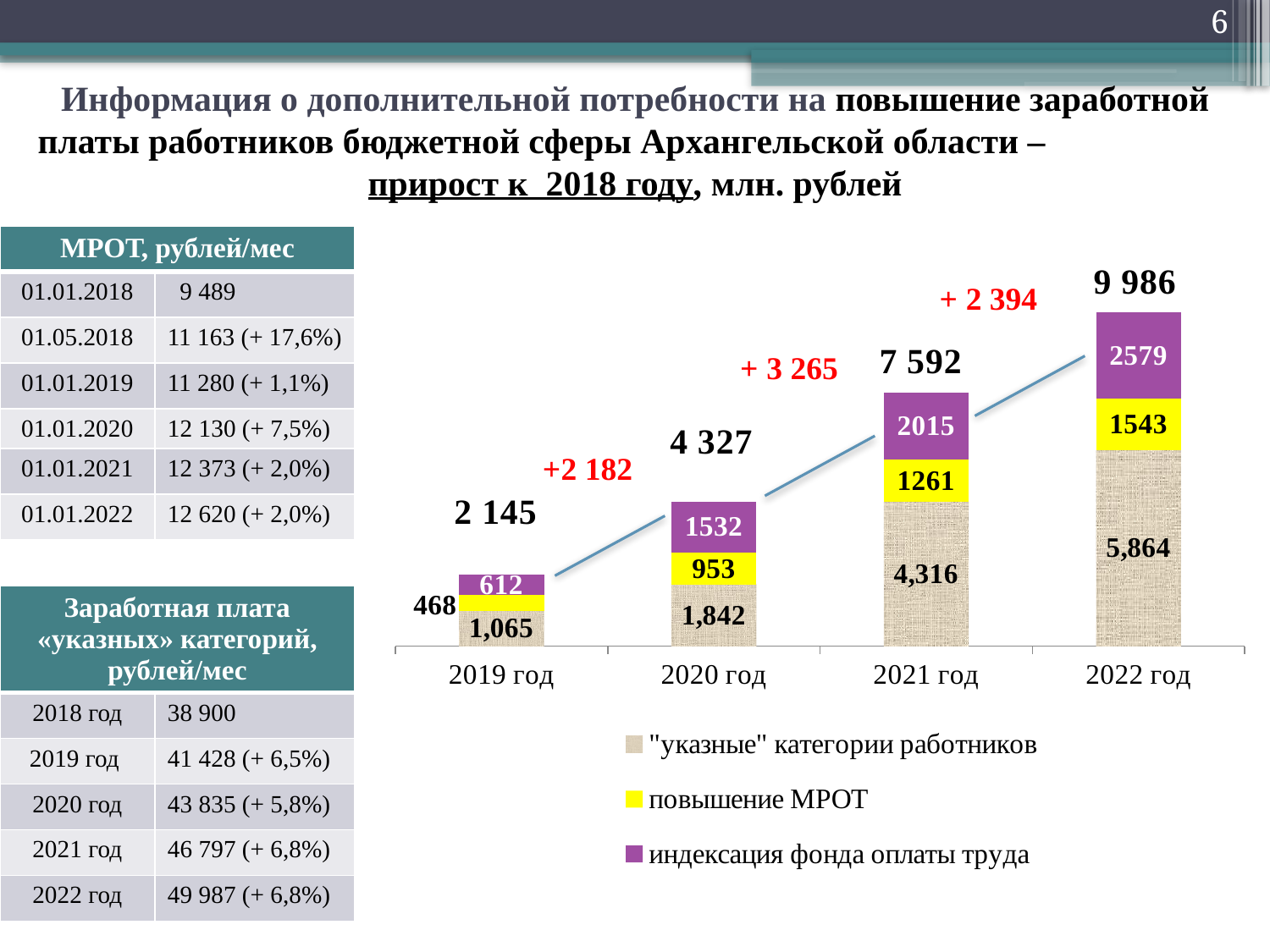
What is the value of the индексация фонда оплаты труда segment for 2022 год? 2579 What is the value of the повышение МРОТ segment for 2020 год? 953 What is the value of the "указные" категории работников segment for 2021 год? 4,316 Which year has the highest total in the chart? 2022 год How many years (categories) are shown on the x axis of the chart? 4 What is the difference between the индексация фонда оплаты труда values for 2022 год and 2021 год? 564 How many series does the chart legend list? 3 Which is larger: the повышение МРОТ value for 2019 год or for 2020 год? 2020 год What is the total of the stacked bar for 2021 год? 7 592 Do the bar totals rise or fall from 2019 год to 2022 год? rise What kind of chart is shown on the slide? stacked bar chart Which year has the lowest total in the chart? 2019 год